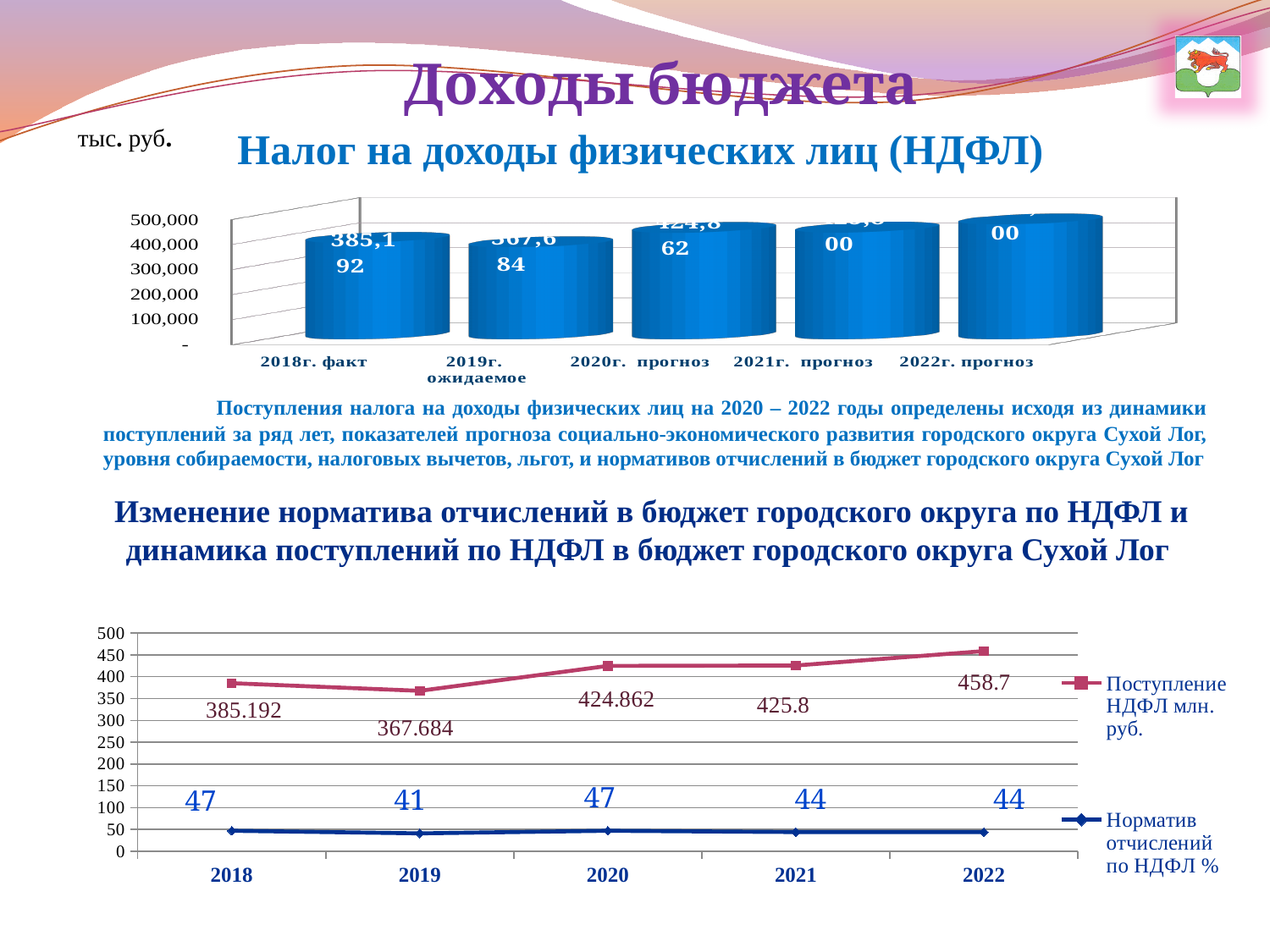
What kind of chart is the bottom chart? Line chart In the bottom chart, which year has the lowest value of Поступление НДФЛ млн. руб.? 2019 How many series does the legend of the bottom chart list? 2 In the bottom chart, which year has the highest value of Поступление НДФЛ млн. руб.? 2022 How many years are shown on the x axis of the bottom chart? 5 In the bottom chart, what is the difference between the Поступление НДФЛ values for 2022 and 2021? 32.9 In the top chart, is the value for 2022г. прогноз greater or less than 400,000? greater What kind of chart is the top chart titled Налог на доходы физических лиц (НДФЛ)? Bar chart In the bottom chart, is the Норматив отчислений по НДФЛ % higher in 2018 or in 2019? 2018 In the bottom chart, what is the value of Поступление НДФЛ млн. руб. for 2022? 458.7 In the bottom chart, what is the Норматив отчислений по НДФЛ % for 2019? 41 In the bottom chart, what is the value of Поступление НДФЛ млн. руб. for 2018? 385.192